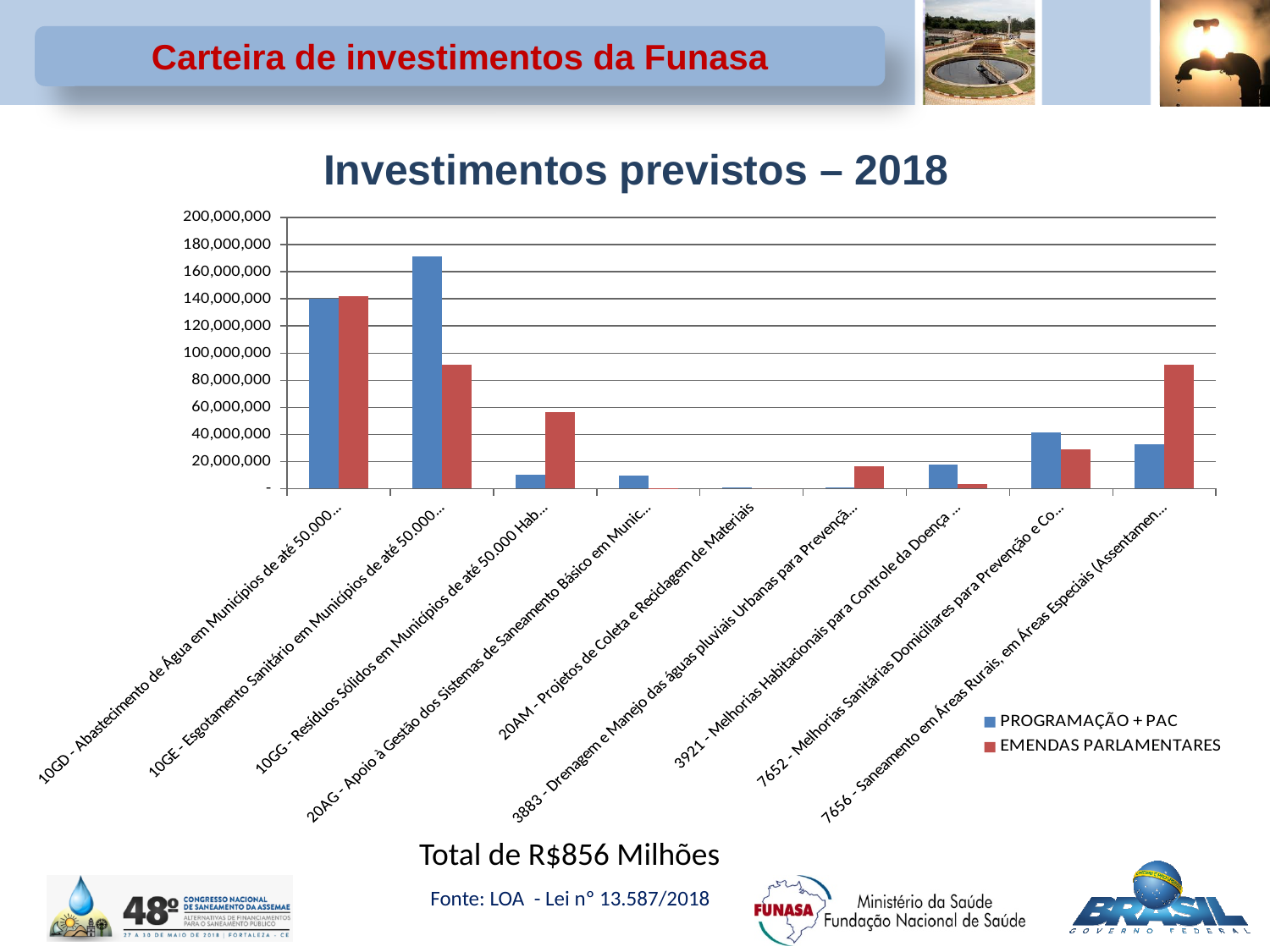
What is the title of the chart? Investimentos previstos – 2018 How many series does the chart legend list? 2 How many categories are plotted along the x axis of the chart? 9 Is the EMENDAS PARLAMENTARES value for 10GG - Resíduos Sólidos greater or less than 40,000,000? greater Is the PROGRAMAÇÃO + PAC value for 10GE - Esgotamento Sanitário greater or less than 160,000,000? greater Which category has the highest EMENDAS PARLAMENTARES value? 10GD - Abastecimento de Água em Municípios de até 50.000 Which category has the highest PROGRAMAÇÃO + PAC value? 10GE - Esgotamento Sanitário em Municípios de até 50.000 For 10GE - Esgotamento Sanitário, which series has the larger value, PROGRAMAÇÃO + PAC or EMENDAS PARLAMENTARES? PROGRAMAÇÃO + PAC For 10GG - Resíduos Sólidos, which series has the larger value, PROGRAMAÇÃO + PAC or EMENDAS PARLAMENTARES? EMENDAS PARLAMENTARES What kind of chart is shown on the slide? bar chart Which colour represents the EMENDAS PARLAMENTARES series in the chart? red Is the EMENDAS PARLAMENTARES value for 7656 - Saneamento em Áreas Rurais greater or less than 100,000,000? less